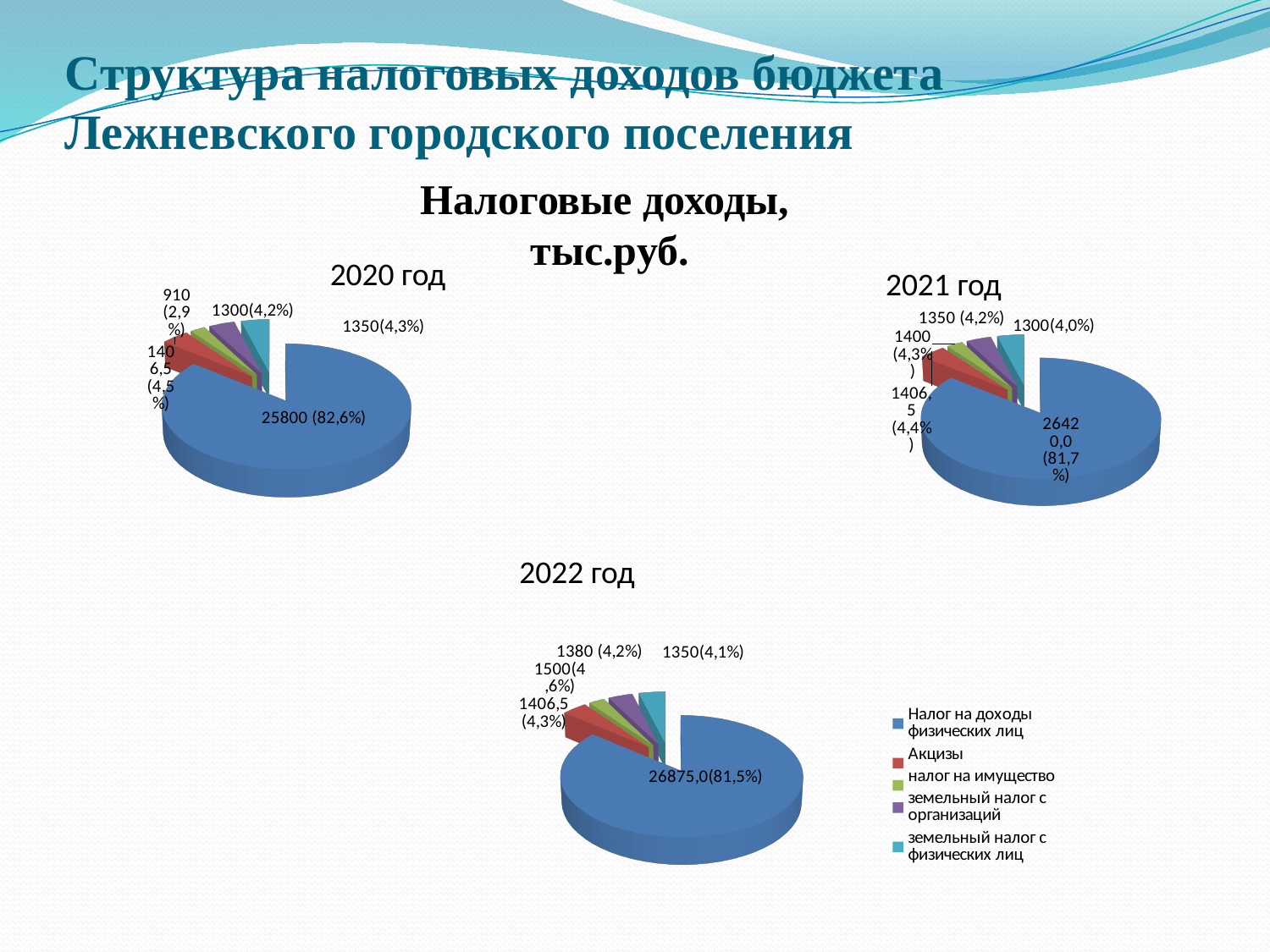
How many pie charts are on the slide? 3 What is the common title above the charts? Налоговые доходы, тыс.руб. In the 2021 год chart, what share does the largest slice have? 81,7% Which legend category is shown in blue? Налог на доходы физических лиц What is the difference between the largest slice in 2021 год (26420,0) and the largest slice in 2020 год (25800)? 620 What type of charts are shown on the slide? Pie charts How many categories does the legend list? 5 Which is larger: the largest slice in the 2022 год chart or the largest slice in the 2020 год chart? 2022 год (26875,0) In the 2020 год chart, what is the value of the largest slice? 25800 (82,6%) In the 2020 год chart, which slice is the smallest? 910 (2,9%) In the 2022 год chart, what is the value labelled for the slice with 4,6%? 1500 In the 2022 год chart, what is the value of the largest slice? 26875,0(81,5%)